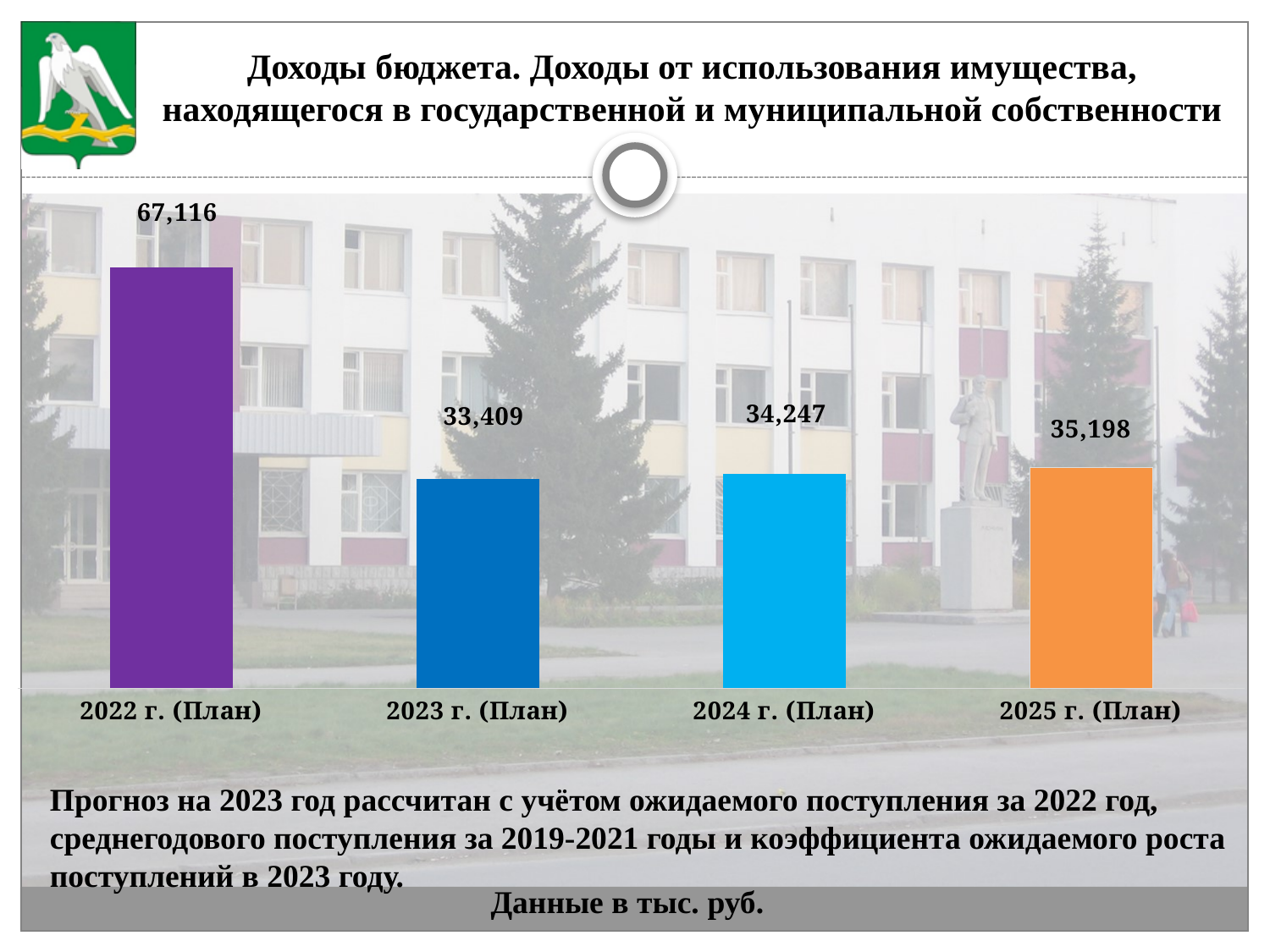
What kind of chart is shown on the slide? Bar chart Which is larger, the value for 2024 г. (План) or 2023 г. (План)? 2024 г. (План) What is the value for 2024 г. (План)? 34,247 Which year has the highest value? 2022 г. (План) What is the difference between the values for 2022 г. (План) and 2023 г. (План)? 33,707 What is the value for 2025 г. (План)? 35,198 Which year has the lowest value? 2023 г. (План) What is the value for 2023 г. (План)? 33,409 From 2023 г. (План) to 2025 г. (План), do the values rise or fall? Rise What is the difference between the values for 2025 г. (План) and 2024 г. (План)? 951 How many bars are shown in the chart? 4 What is the value for 2022 г. (План)? 67,116